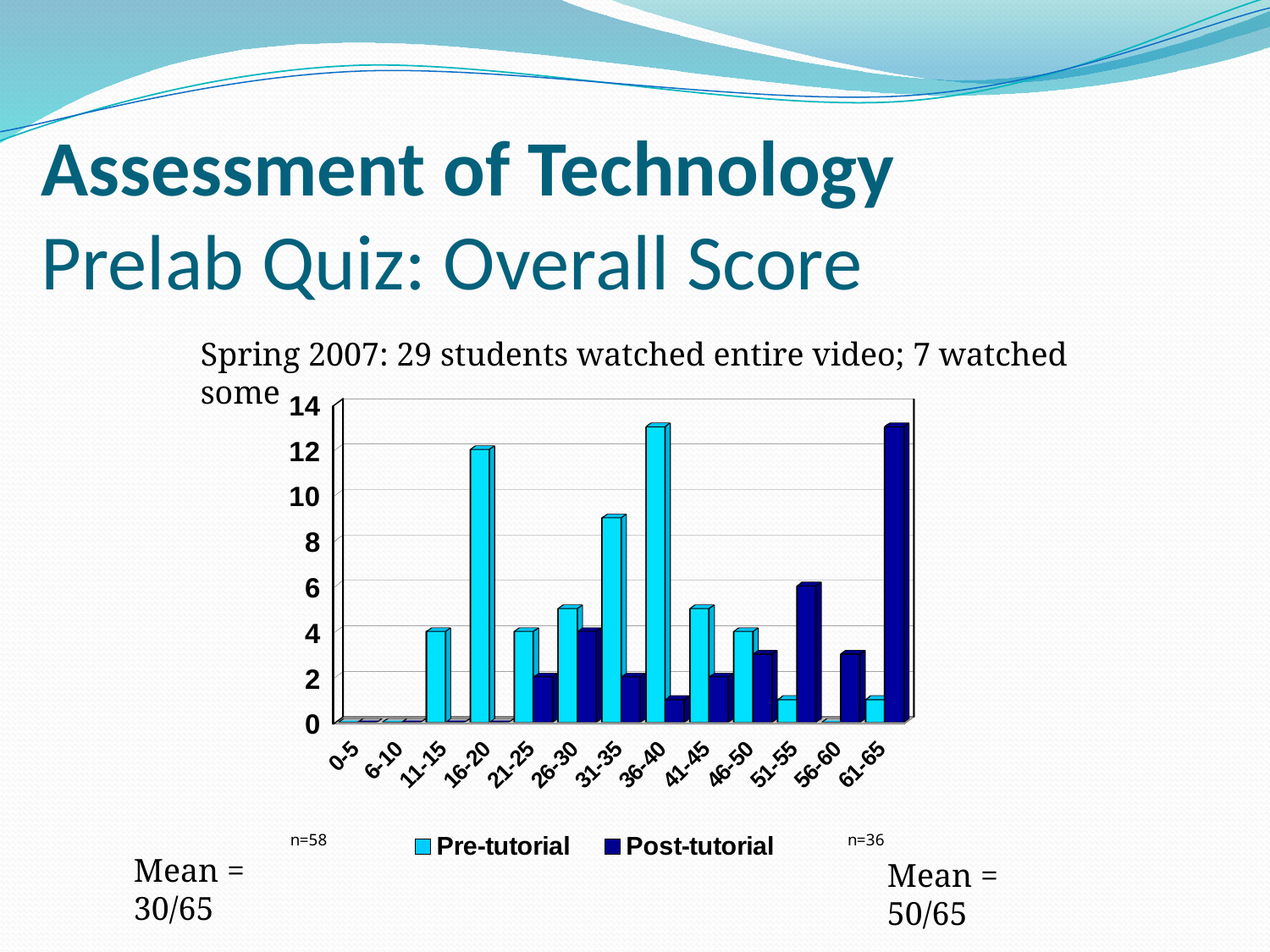
What is the Post-tutorial value for the 26-30 score range? 4 For the 16-20 score range, which series has the larger value, Pre-tutorial or Post-tutorial? Pre-tutorial What is the Pre-tutorial value for the 16-20 score range? 12 Which score range has the highest Post-tutorial value? 61-65 What is the Pre-tutorial value for the 11-15 score range? 4 How many score-range categories are shown on the x axis? 13 What is the Post-tutorial value for the 51-55 score range? 6 Which score range has the highest Pre-tutorial value? 36-40 How many series does the legend list? 2 Is the Post-tutorial value for the 61-65 score range greater or less than 12? greater What kind of chart is shown on the slide? bar chart What are the two entries in the chart legend? Pre-tutorial and Post-tutorial